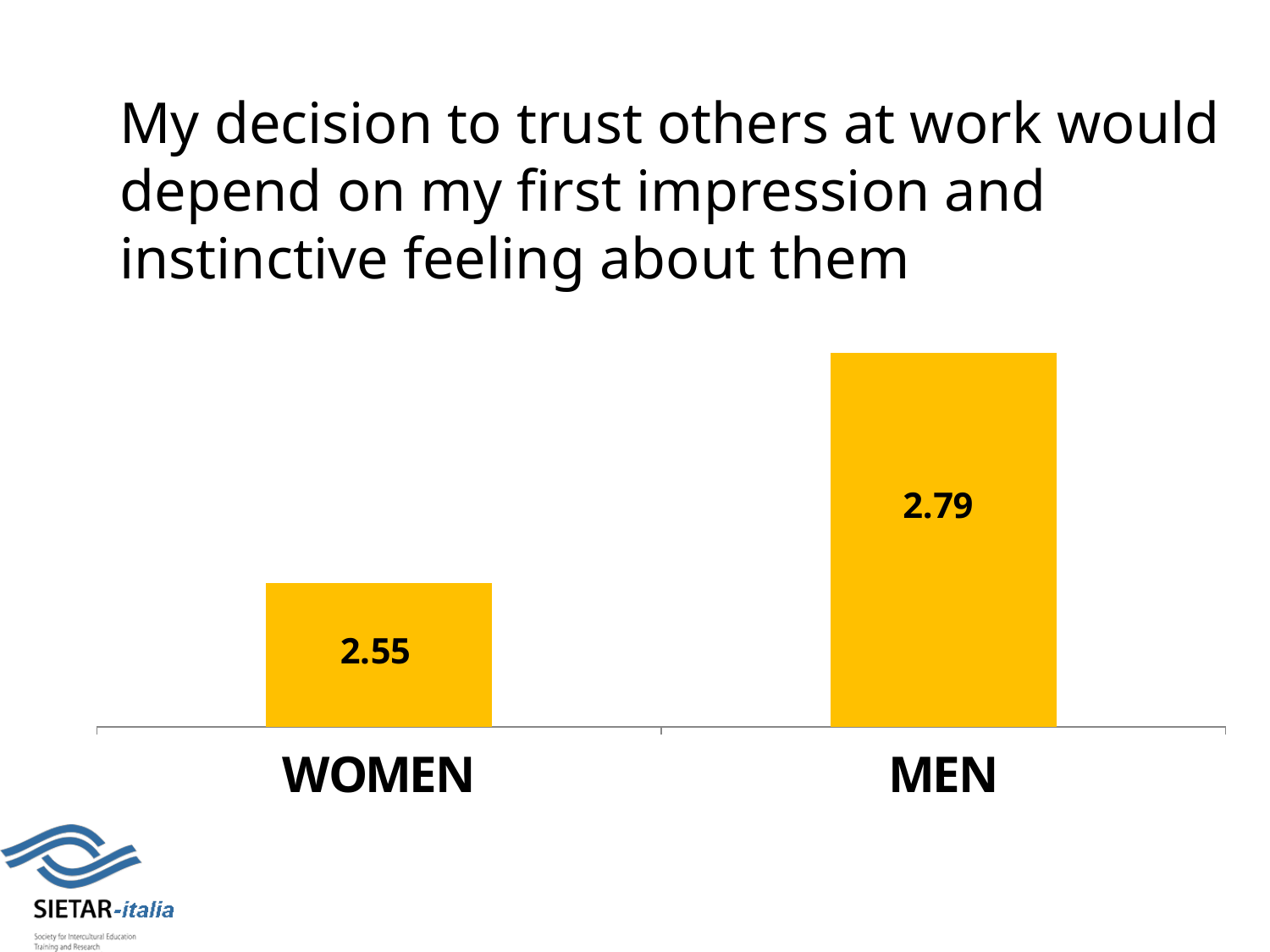
Which is larger, the value for WOMEN or the value for MEN? MEN What kind of chart is shown on the slide? bar chart Which category has the highest value? MEN How many categories are shown in the chart? 2 What is the value for MEN? 2.79 What is the value for WOMEN? 2.55 Do the values rise or fall from WOMEN to MEN? rise What is the difference between the values for MEN and WOMEN? 0.24 What colour are the bars in the chart? yellow What is the title of the slide above the chart? My decision to trust others at work would depend on my first impression and instinctive feeling about them Which category has the lowest value? WOMEN